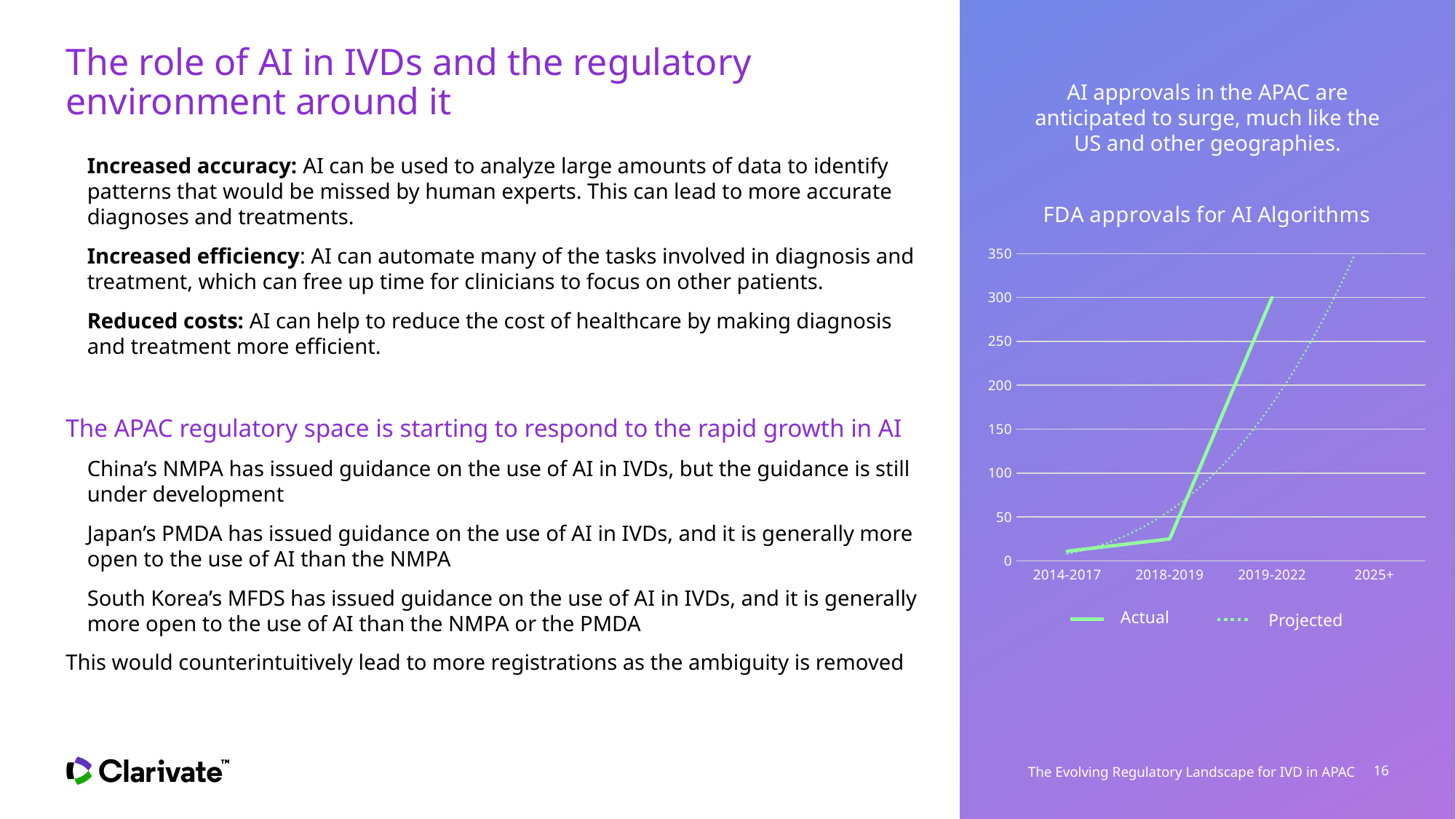
In the 'FDA approvals for AI Algorithms' chart, which series is drawn with a dotted line? Projected What kind of chart is the 'FDA approvals for AI Algorithms' chart? line chart In the 'FDA approvals for AI Algorithms' chart, does the Actual series rise or fall from 2014-2017 to 2019-2022? rise In the 'FDA approvals for AI Algorithms' chart, which period has the highest Actual value? 2019-2022 In the 'FDA approvals for AI Algorithms' chart, is the Projected value for 2025+ greater or less than 300? greater How many series does the legend of the 'FDA approvals for AI Algorithms' chart list? 2 What is the title of the chart on the right side of the slide? FDA approvals for AI Algorithms How many categories are shown on the x axis of the 'FDA approvals for AI Algorithms' chart? 4 In the 'FDA approvals for AI Algorithms' chart, is the Actual value for 2018-2019 greater or less than 50? less In the 'FDA approvals for AI Algorithms' chart, is the Actual value for 2019-2022 greater or less than 250? greater In the 'FDA approvals for AI Algorithms' chart, for 2019-2022, which is larger: the Actual value or the Projected value? Actual